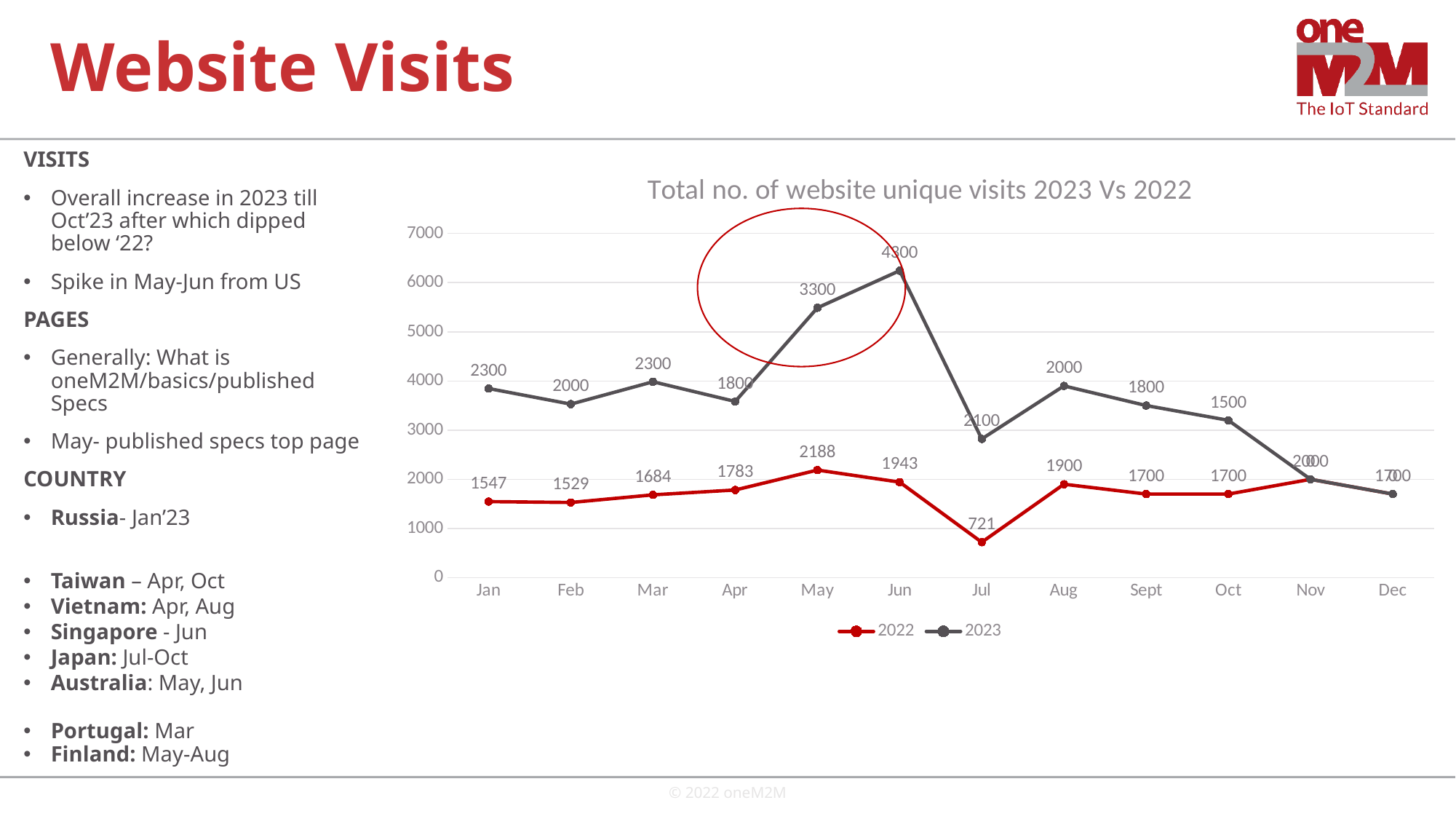
What is the title of the chart? Total no. of website unique visits 2023 Vs 2022 What is the 2022 value for May? 2188 What kind of chart is shown on the slide? line chart What is the 2022 value for Jul? 721 Which is larger, the 2022 value for Mar or the 2022 value for Apr? Apr In which month is the 2022 series highest? May What is the difference between the 2023 and 2022 values for May? 1112 In which month is the 2023 series highest? Jun What is the 2023 value for Jul? 2100 In which month is the 2022 series lowest? Jul How many series does the chart legend list? 2 How many months are plotted along the x axis? 12